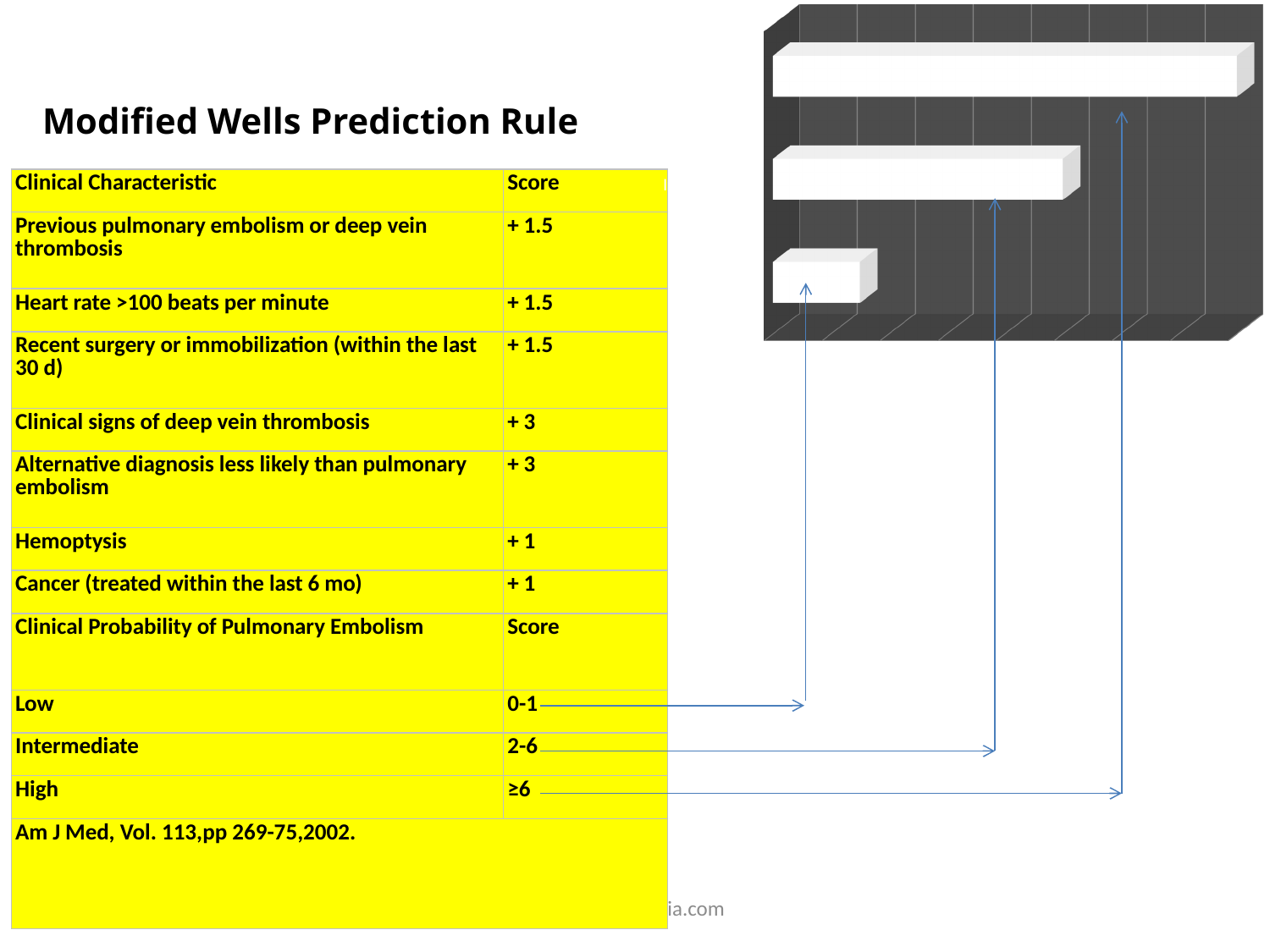
In the chart on the right, is the middle bar or the bottom bar longer? middle bar Which bar in the chart on the right is the longest: the top, middle, or bottom bar? top bar What kind of chart is shown on the right side of the slide? bar chart Going from the bottom bar to the top bar in the chart on the right, do the bar lengths increase or decrease? increase Which clinical probability category from the table does the arrow connect to the longest bar in the chart? High In the chart on the right, is the top bar or the middle bar longer? top bar Which bar in the chart on the right is the shortest: the top, middle, or bottom bar? bottom bar How many bars does the chart on the right side of the slide contain? 3 Which clinical probability category from the table does the arrow connect to the shortest bar in the chart? Low